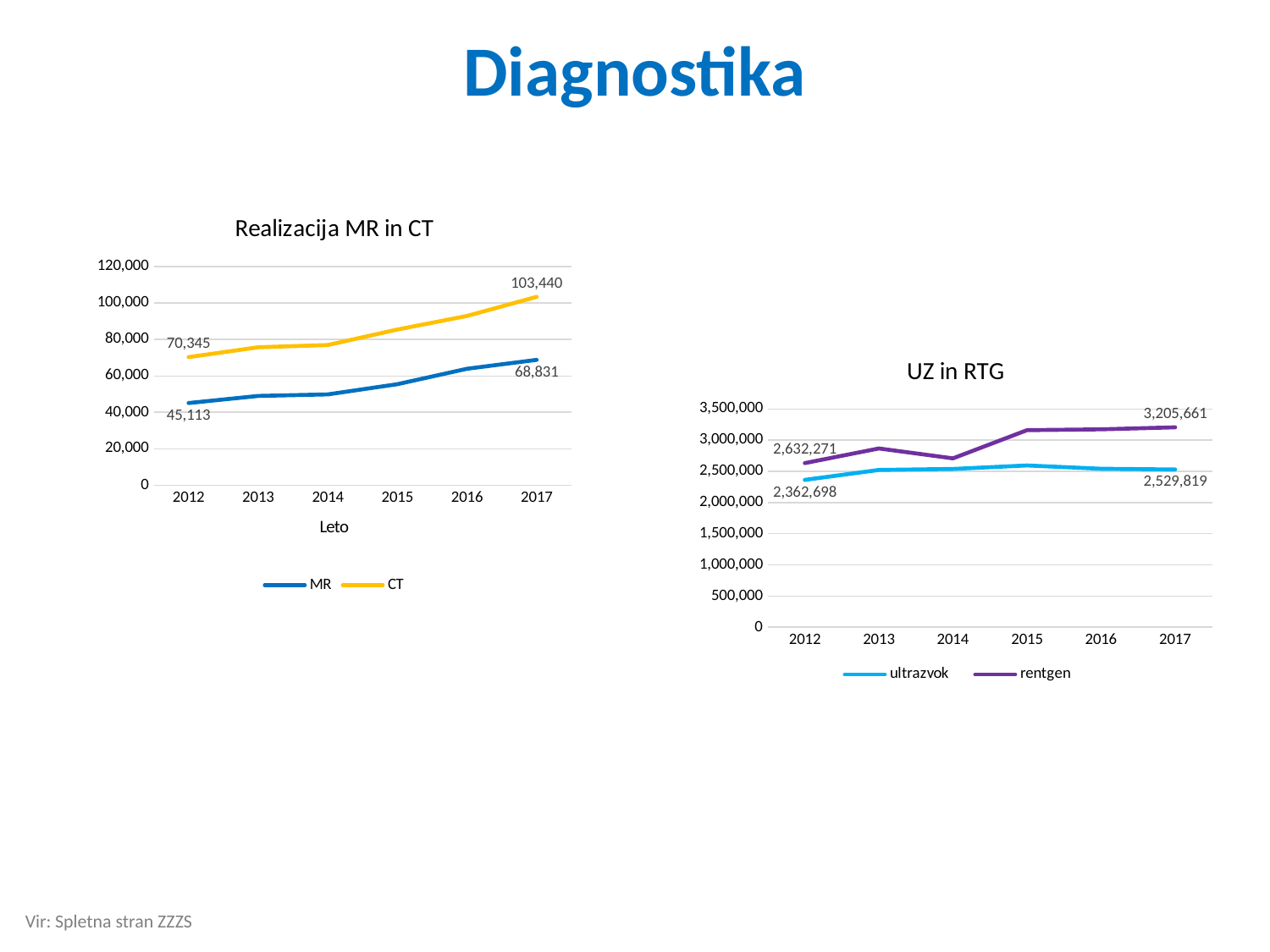
In the chart titled "UZ in RTG", what is the value for rentgen in 2017? 3,205,661 In the chart titled "Realizacija MR in CT", does the MR series rise or fall from 2012 to 2017? rise In the chart titled "Realizacija MR in CT", is the value for MR in 2015 greater or less than 60,000? less In the chart titled "Realizacija MR in CT", what is the value for CT in 2017? 103,440 In the chart titled "UZ in RTG", what is the value for ultrazvok in 2012? 2,362,698 In the chart titled "UZ in RTG", what is the difference between the rentgen value and the ultrazvok value in 2017? 675,842 What kind of chart is the chart titled "Realizacija MR in CT"? line chart In the chart titled "UZ in RTG", how many years are shown on the x axis? 6 In the chart titled "Realizacija MR in CT", which series has the higher value in 2017, MR or CT? CT In the chart titled "Realizacija MR in CT", what is the value for MR in 2012? 45,113 In the chart titled "UZ in RTG", how many series does the legend list? 2 In the chart titled "Realizacija MR in CT", what is the difference between the CT value in 2017 and the CT value in 2012? 33,095